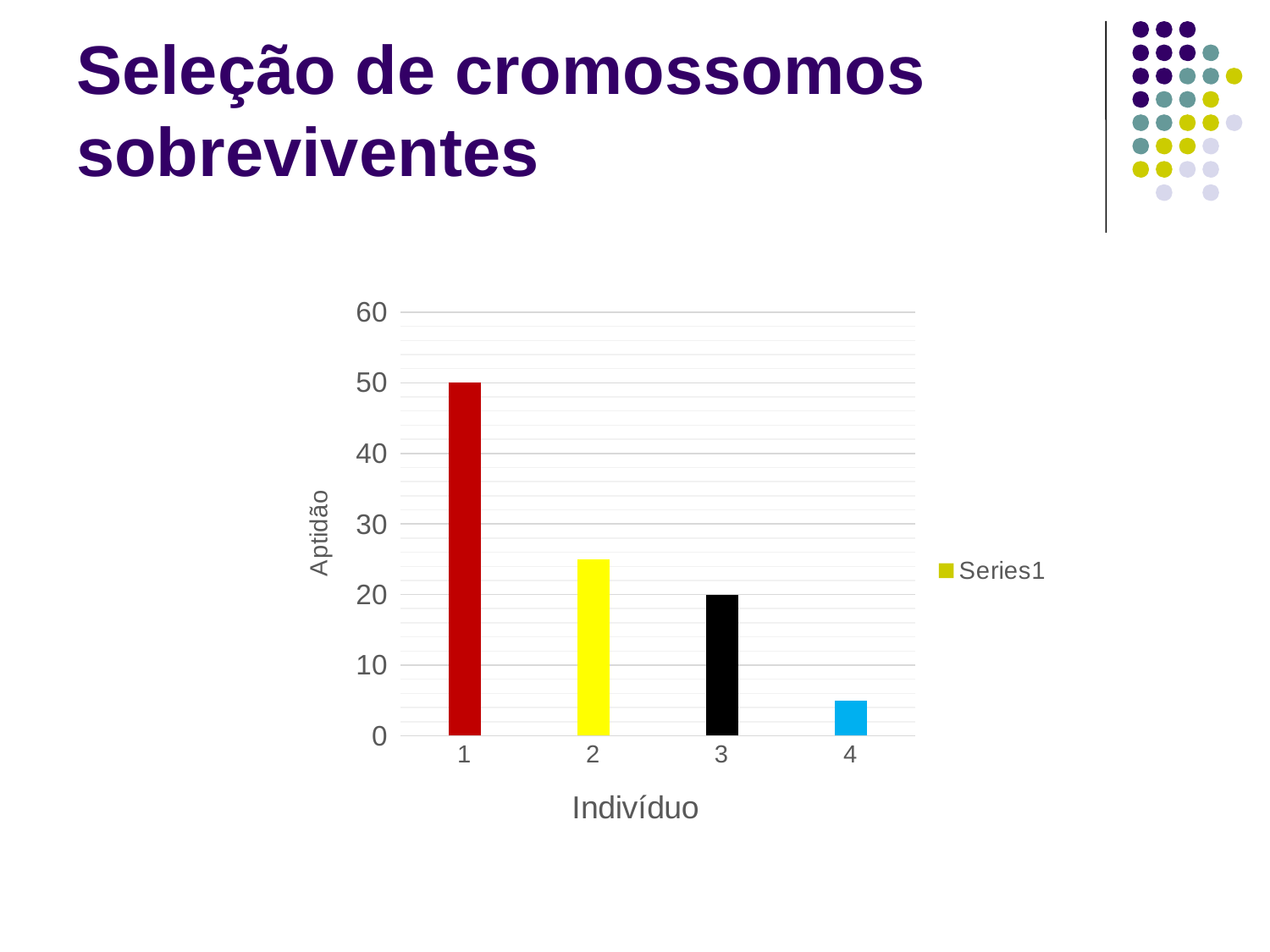
Which has a higher Aptidão, Indivíduo 2 or Indivíduo 3? 2 How many series does the legend list? 1 How many individuals (bars) are shown in the chart? 4 What is the difference in Aptidão between Indivíduo 1 and Indivíduo 3? 30 Do the Aptidão values rise or fall from Indivíduo 1 to Indivíduo 4? fall Is the Aptidão value for Indivíduo 4 greater or less than 10? less What kind of chart is shown on the slide? bar chart Which Indivíduo has the lowest Aptidão? 4 Is the Aptidão value for Indivíduo 2 greater or less than 20? greater Which Indivíduo has the highest Aptidão? 1 What is the Aptidão value for Indivíduo 1? 50 What is the Aptidão value for Indivíduo 3? 20